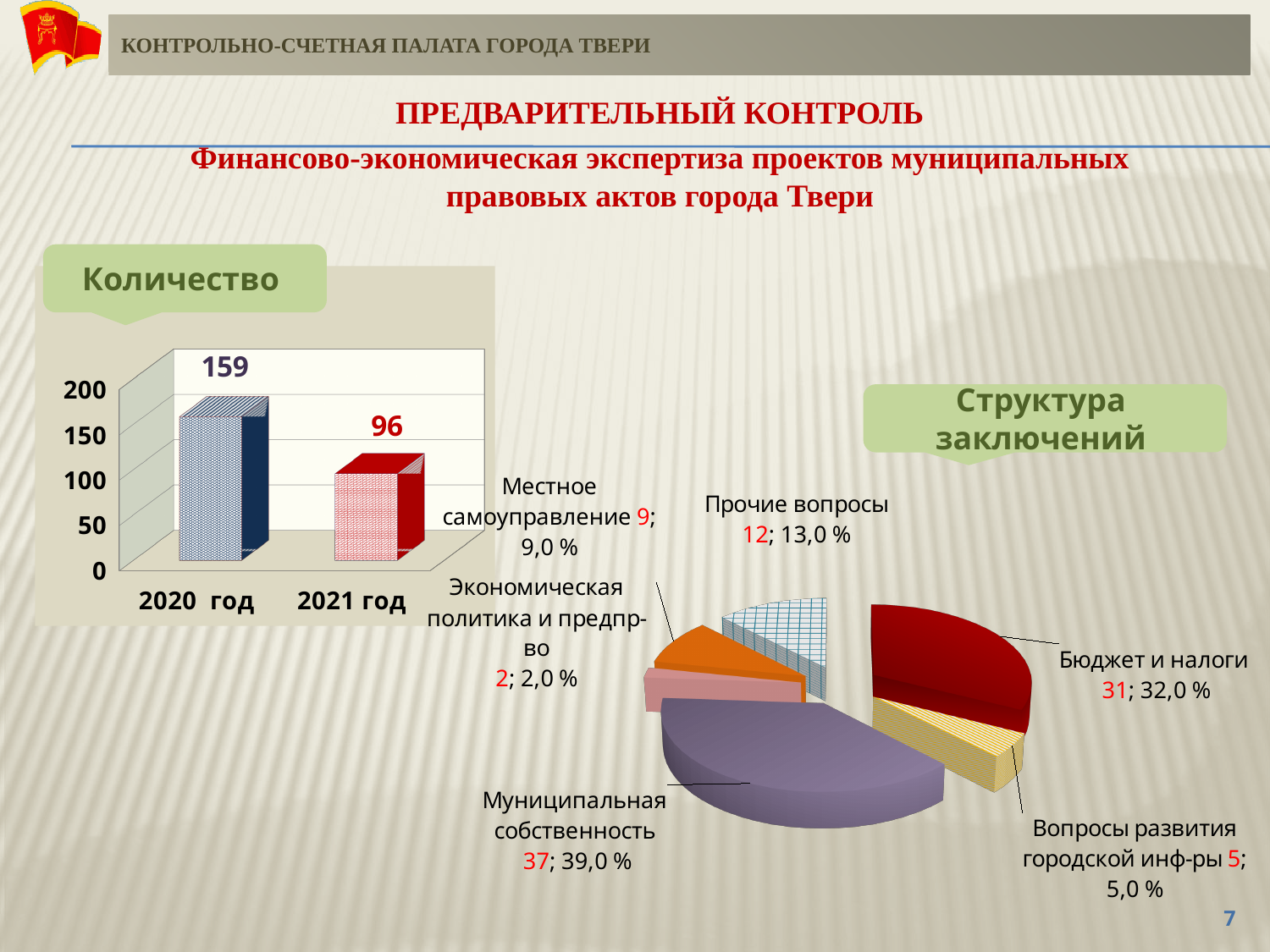
In the "Структура заключений" chart, what share does Бюджет и налоги have? 32,0 % In the "Структура заключений" chart, which is larger: Прочие вопросы or Местное самоуправление? Прочие вопросы In the "Структура заключений" chart, which category has the smallest slice? Экономическая политика и предпр-во In the "Количество" chart, what is the value for 2021 год? 96 In the "Структура заключений" chart, which category has the largest slice? Муниципальная собственность In the "Количество" chart, what is the difference between the values for 2020 год and 2021 год? 63 In the "Количество" chart, what is the value for 2020 год? 159 What kind of chart is the "Количество" chart? bar chart In the "Структура заключений" chart, what is the value for Муниципальная собственность? 37; 39,0 % What kind of chart is the "Структура заключений" chart? pie chart How many slices does the "Структура заключений" pie chart have? 6 In the "Количество" chart, do the values rise or fall from 2020 год to 2021 год? fall